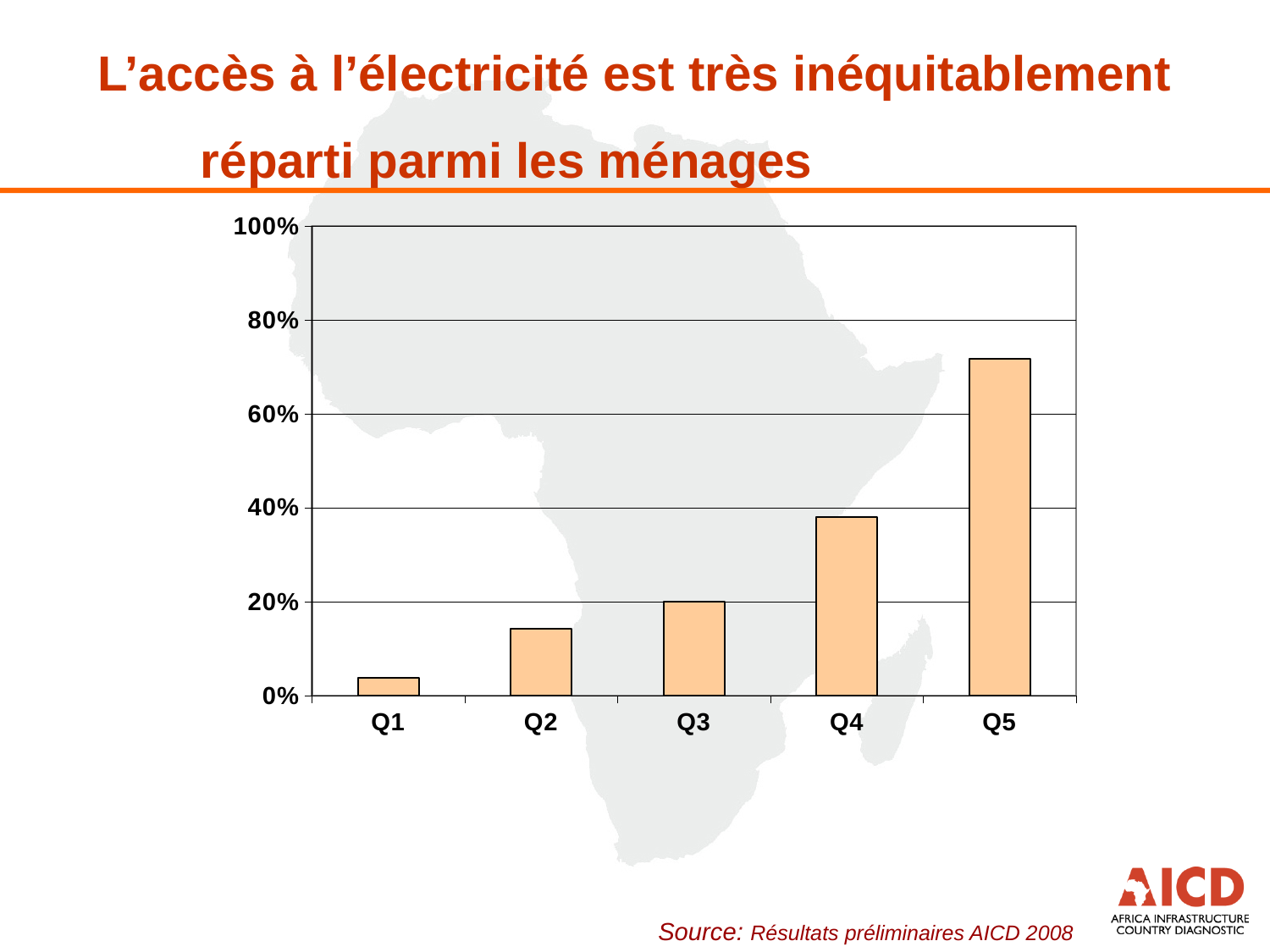
Is the value for Q5 greater or less than 80%? less Which category has the lowest value in the chart? Q1 Do the values rise or fall from Q1 to Q5 along the x axis? rise What is the source cited below the chart? Résultats préliminaires AICD 2008 How many categories are shown on the x axis of the chart? 5 Is the value for Q1 greater or less than 20%? less Which is larger, the value for Q4 or the value for Q2? Q4 Which category has the highest value in the chart? Q5 Is the value for Q5 greater or less than 60%? greater What kind of chart is shown on the slide? bar chart